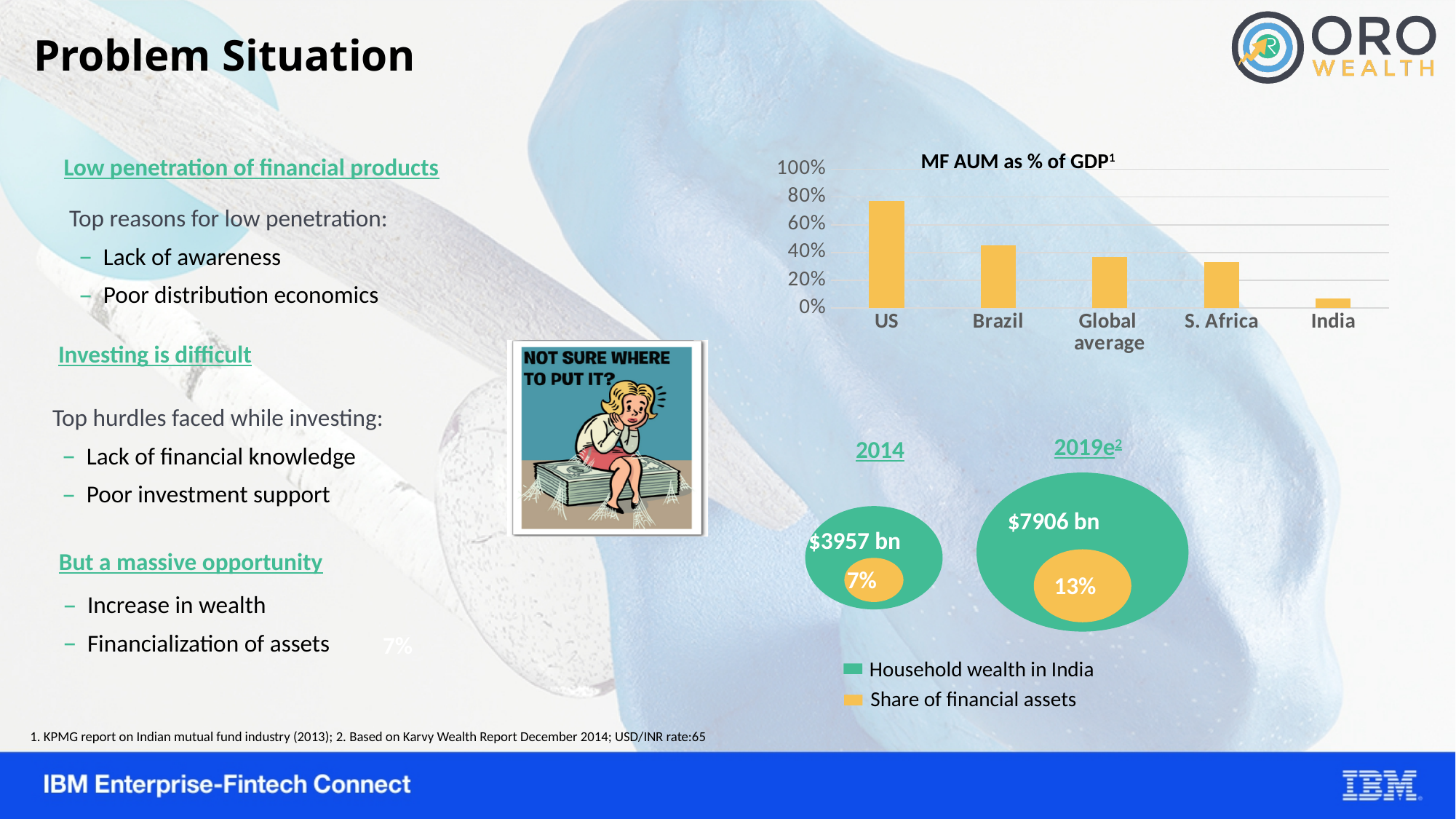
In the 'MF AUM as % of GDP' chart, which category has the highest value? US In the bubble diagram at the bottom right, what share of financial assets is shown for 2019e? 13% In the 'MF AUM as % of GDP' chart, is the value for India greater or less than 20%? less In the 'MF AUM as % of GDP' chart, is the value for US greater or less than 60%? greater In the 'MF AUM as % of GDP' chart, which is larger, the value for Brazil or the value for S. Africa? Brazil How many entries does the legend of the bubble diagram at the bottom right list? 2 In the 'MF AUM as % of GDP' chart, which category has the lowest value? India How many categories are shown in the 'MF AUM as % of GDP' chart? 5 In the 'MF AUM as % of GDP' chart, do the values rise or fall from left to right across the categories? fall In the bubble diagram at the bottom right, what is the household wealth in India shown for 2014? $3957 bn What kind of chart is the 'MF AUM as % of GDP' chart? bar chart In the 'MF AUM as % of GDP' chart, is the value for Brazil greater or less than 40%? greater